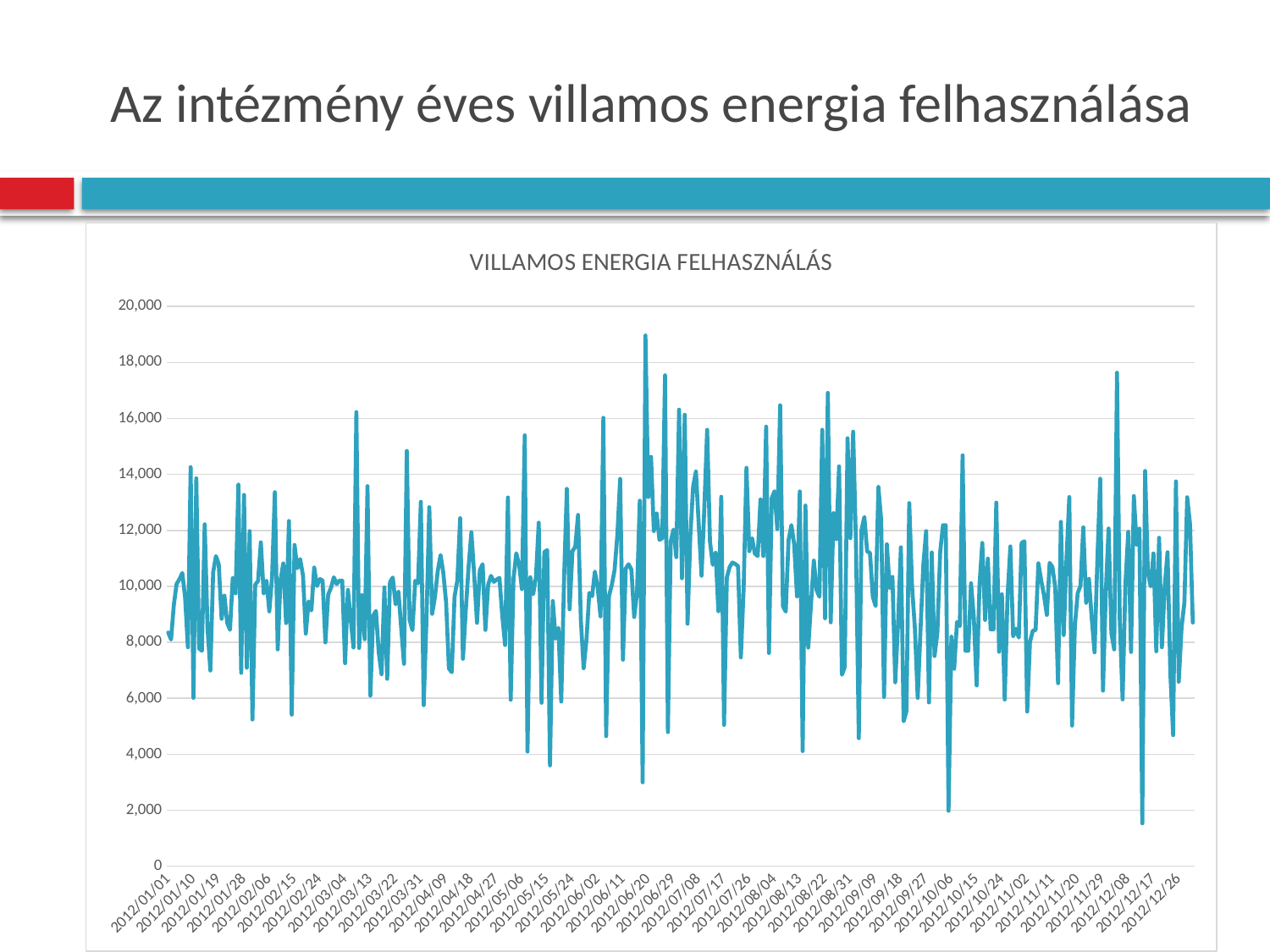
What kind of chart is shown on the slide? line chart What is the highest value shown on the vertical axis of the chart? 20,000 Is the value at 2012/01/01 greater or less than 10,000? less Which is higher: the peak near 2012/06/20 or the peak near 2012/12/08? the peak near 2012/06/20 Does the highest peak of the line occur in the first half or the second half of the year? first half What is the title of the chart? VILLAMOS ENERGIA FELHASZNÁLÁS Is the peak near 2012/03/04 greater or less than 14,000? greater Is the peak near 2012/12/08 greater or less than 16,000? greater